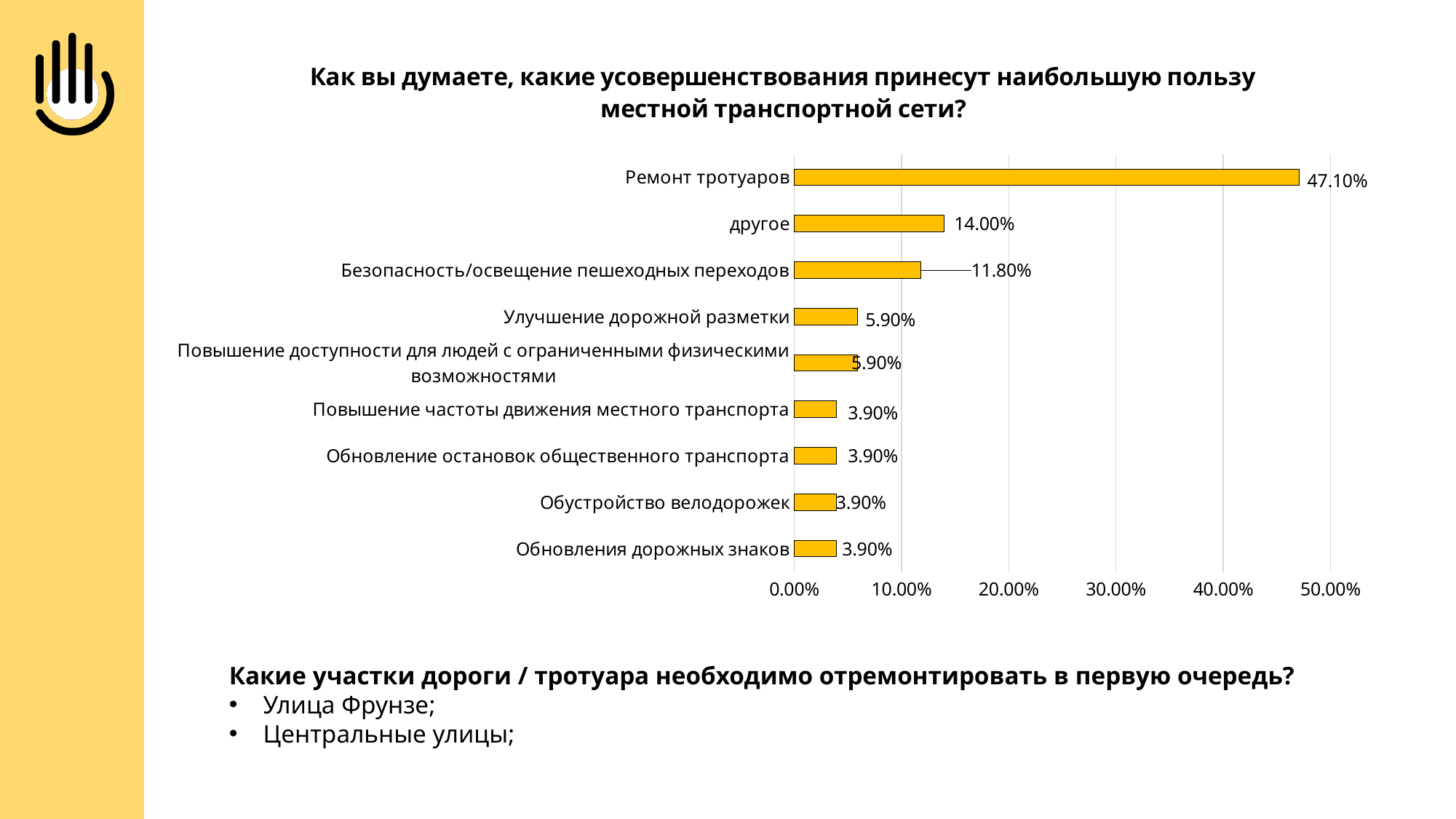
Which is larger, the value for "Безопасность/освещение пешеходных переходов" or the value for "Улучшение дорожной разметки"? Безопасность/освещение пешеходных переходов Which category has the highest value? Ремонт тротуаров Is the value for "Ремонт тротуаров" greater or less than 40.00%? greater What kind of chart is shown on the slide? Bar chart What is the value for "другое"? 14.00% What is the value for "Ремонт тротуаров"? 47.10% What is the value for "Безопасность/освещение пешеходных переходов"? 11.80% What is the difference between the values for "Ремонт тротуаров" and "другое"? 33.10% What is the value for "Обустройство велодорожек"? 3.90% What is the value for "Улучшение дорожной разметки"? 5.90% What is the difference between the values for "другое" and "Безопасность/освещение пешеходных переходов"? 2.20% How many categories are shown in the chart? 9